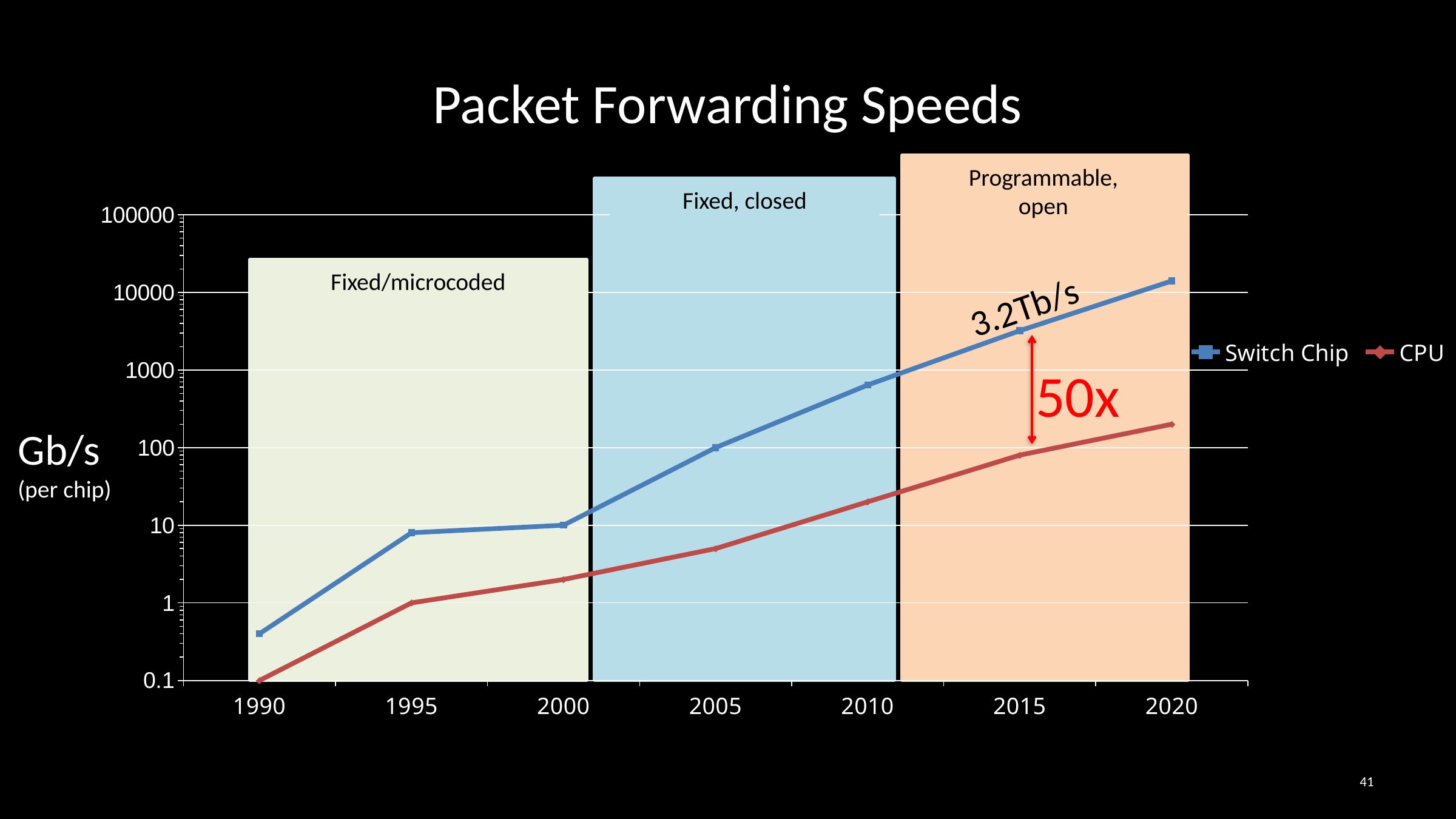
How many years are plotted along the x axis? 7 What is the Switch Chip value in 2000? 10 What kind of chart is shown on the slide? line chart What is the Switch Chip value in 2005? 100 What is the CPU value in 1995? 1 Is the Switch Chip value in 1990 greater or less than 1? less What is the CPU value in 1990? 0.1 Which series has the higher value in 2015, Switch Chip or CPU? Switch Chip Is the Switch Chip value in 2020 greater or less than 10000? greater Do the Switch Chip values rise or fall from 1990 to 2020? rise How many series does the legend list? 2 Is the CPU value in 2020 greater or less than 100? greater